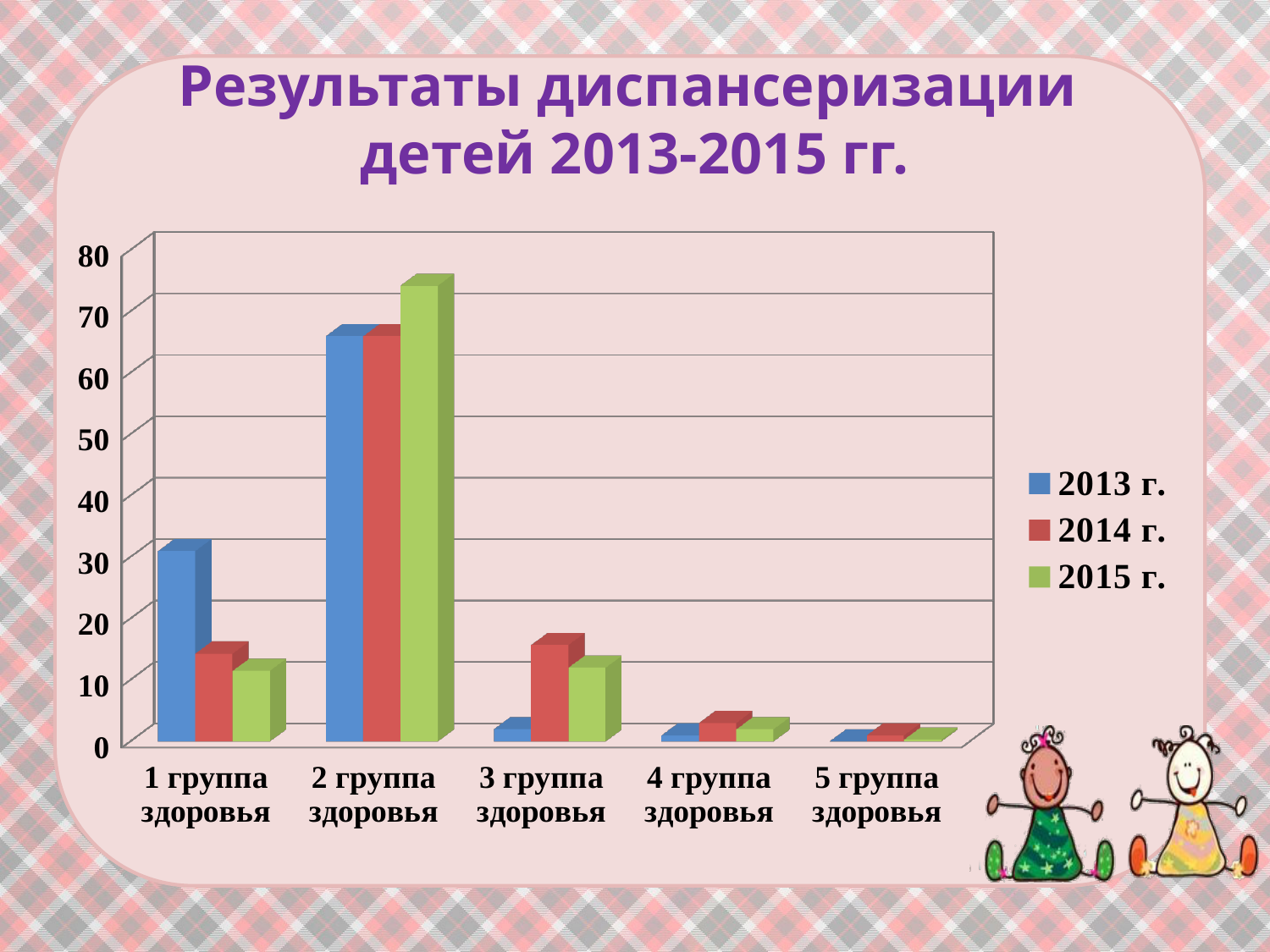
Which year has the highest value for 1 группа здоровья? 2013 г. What kind of chart is shown on the slide? bar chart For 3 группа здоровья, which is larger: the value for 2013 г. or for 2014 г.? 2014 г. Which year has the highest value for 2 группа здоровья? 2015 г. Is the value for 2015 г. in 2 группа здоровья greater or less than 70? greater What is the title of the chart on the slide? Результаты диспансеризации детей 2013-2015 гг. How many series does the legend list? 3 Which health group has the highest value for 2015 г.? 2 группа здоровья Is the value for 2013 г. in 1 группа здоровья greater or less than 20? greater Is the value for 2013 г. in 2 группа здоровья greater or less than 70? less How many health group categories are shown on the x axis? 5 Do the values for 1 группа здоровья rise or fall from 2013 г. to 2015 г.? fall